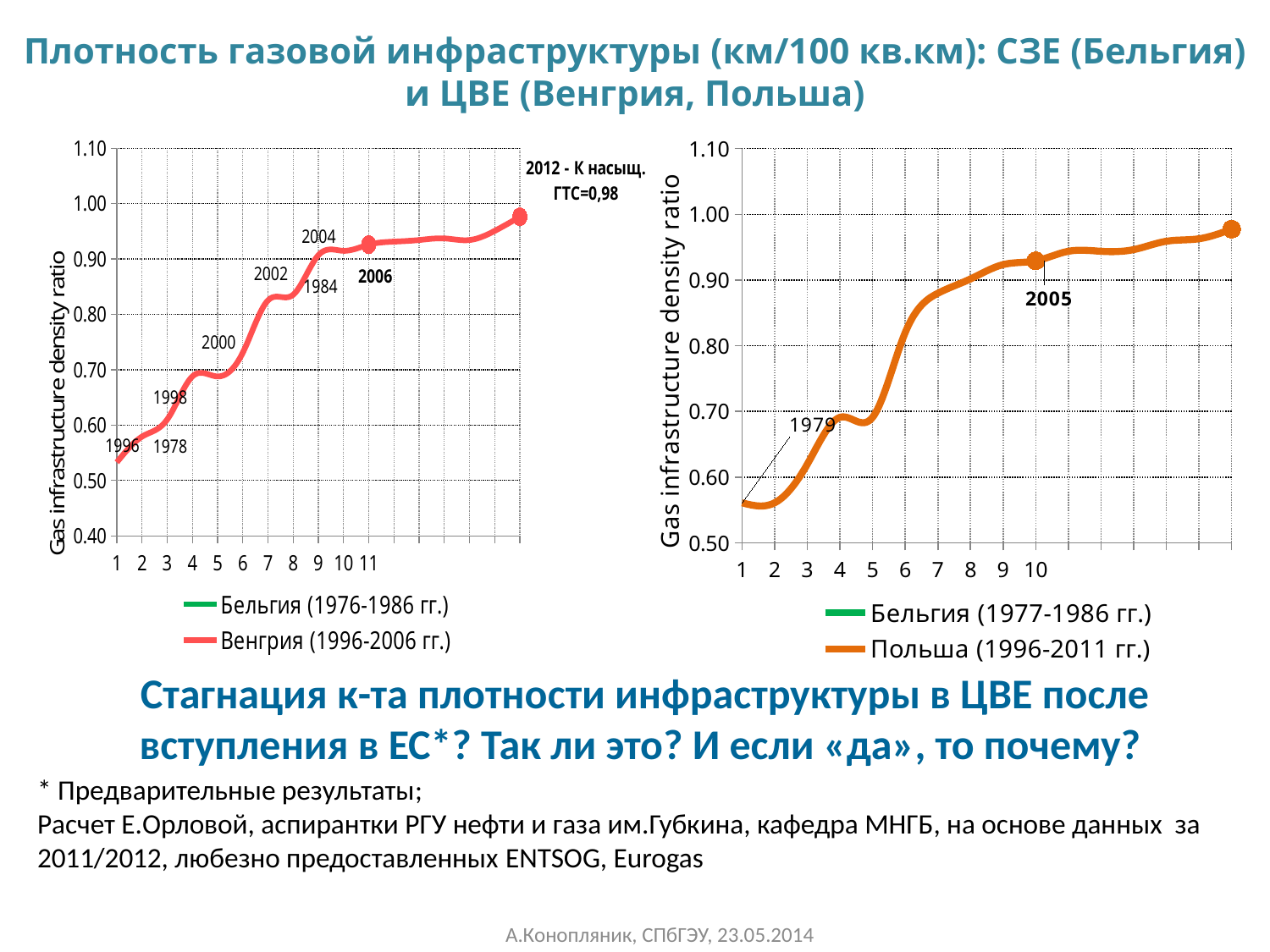
In the left chart, is the value of the Венгрия line at x = 1 greater or less than 0.60? less How many series does the legend of the right chart list? 2 In the left chart, do the values of the Венгрия (1996-2006 гг.) line rise or fall along the x axis? rise In the left chart, is the value of the Венгрия line at x = 11 (marked 2006) greater or less than 0.90? greater In the right chart, is the value of the Польша line at x = 10 (marked 2005) greater or less than 0.90? greater What is the y-axis label of the right chart? Gas infrastructure density ratio Which country series is listed second in the legend of the right chart? Польша (1996-2011 гг.) In the left chart, which is larger for the Венгрия line: the value at x = 1 or the value at x = 11? x = 11 What type of chart is the left chart on the slide? line chart How many series does the legend of the left chart list? 2 In the right chart, do the values of the Польша (1996-2011 гг.) line rise or fall along the x axis? rise